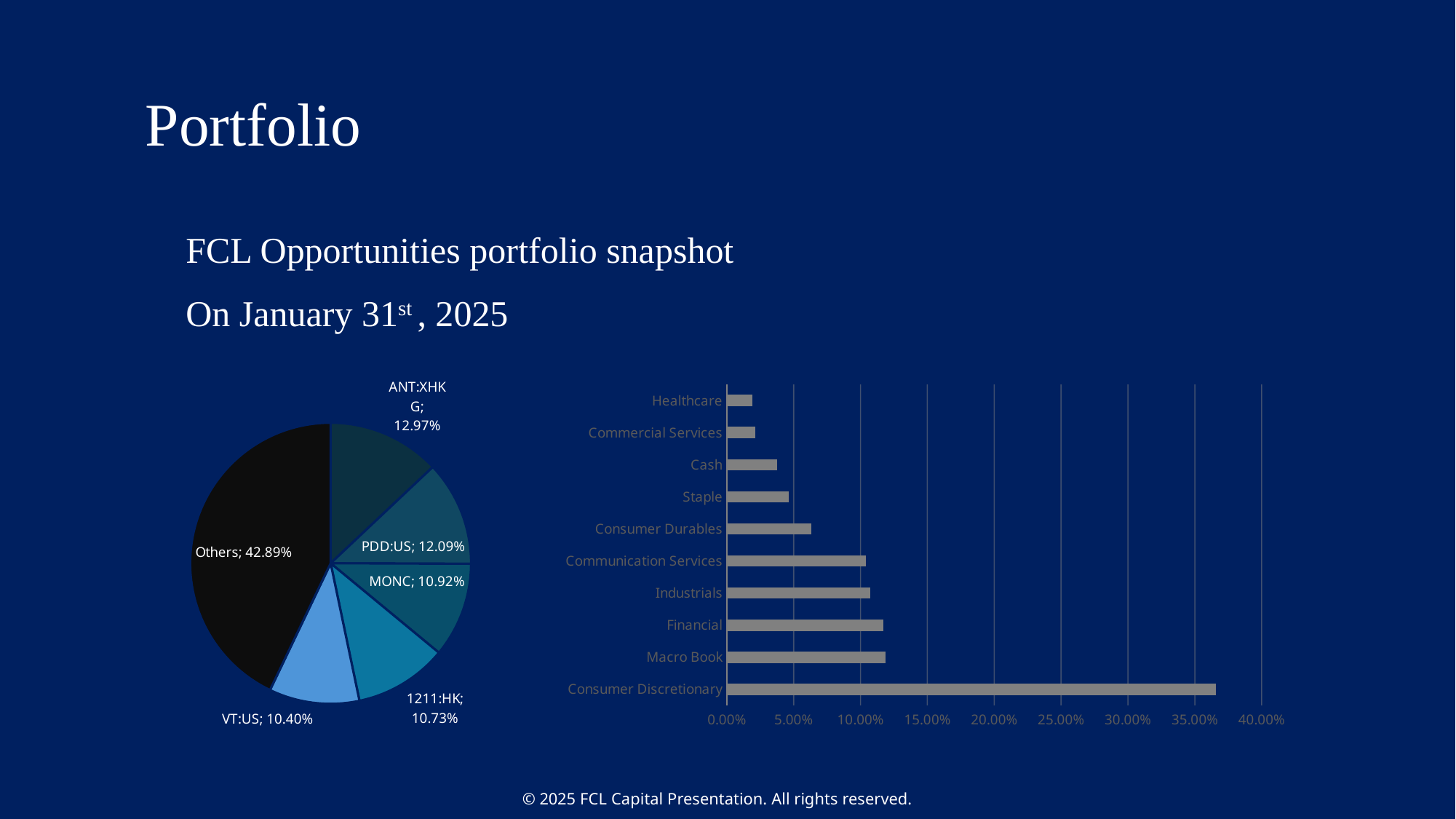
What kind of chart is on the right side of the slide? Bar chart In the pie chart on the left, which slice is the largest? Others In the bar chart on the right, is the value for Consumer Discretionary greater or less than 35.00%? greater In the bar chart on the right, is the value for Cash greater or less than 5.00%? less In the pie chart on the left, what is the value for VT:US? 10.40% In the bar chart on the right, how many categories are shown? 10 In the pie chart on the left, what is the value for PDD:US? 12.09% In the pie chart on the left, how many slices are there? 6 In the pie chart on the left, which slice is the smallest? VT:US In the pie chart on the left, what is the difference between ANT:XHKG and PDD:US? 0.88% In the bar chart on the right, which category has the highest value? Consumer Discretionary In the pie chart on the left, what share does Others hold? 42.89%